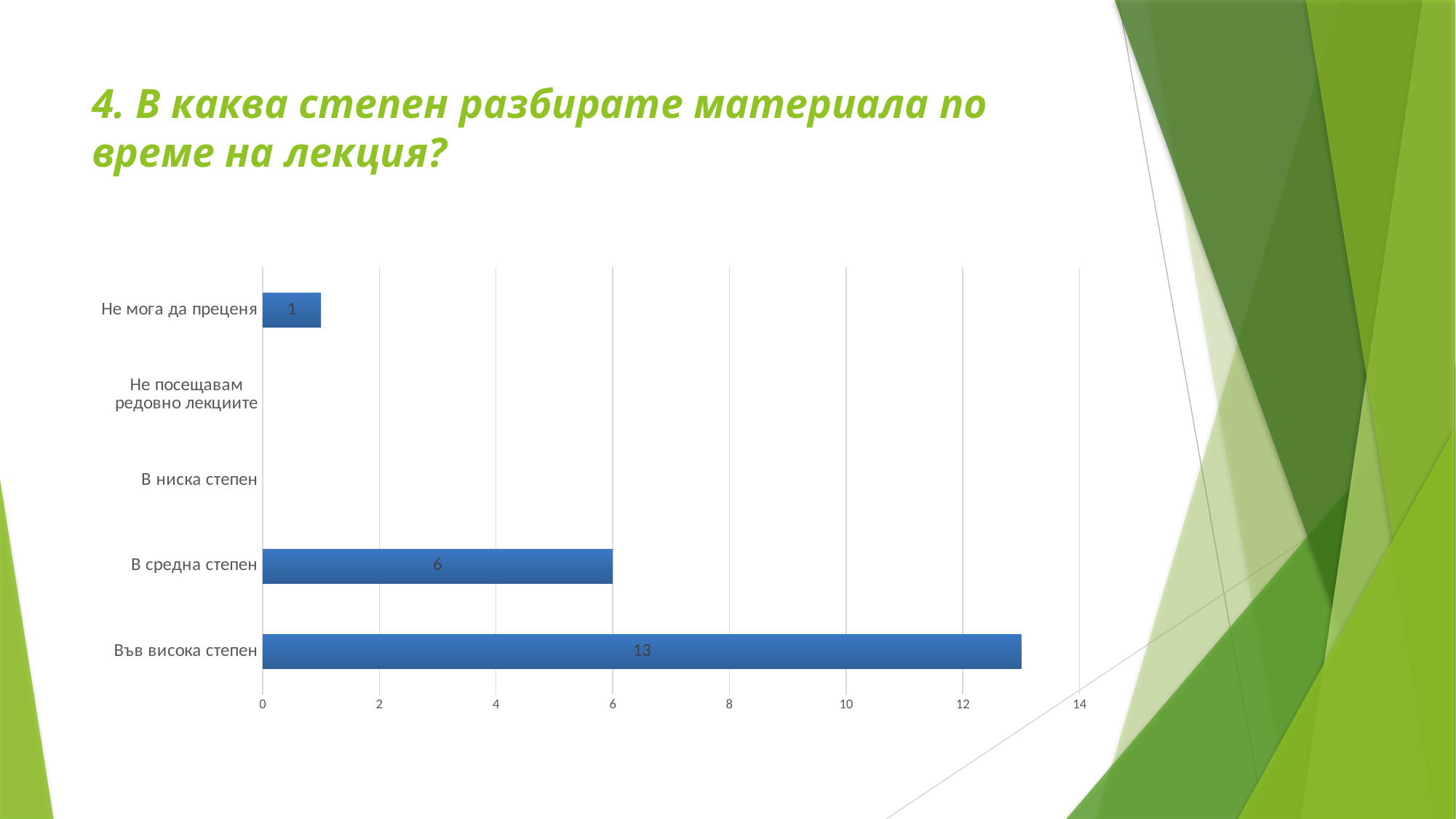
How many categories are listed on the vertical axis of the chart? 5 What is the value for "Във висока степен"? 13 Which category with a visible bar has the lowest value? Не мога да преценя Is the value for "Във висока степен" greater or less than 12? greater Which is larger: the value for "В средна степен" or the value for "Не мога да преценя"? В средна степен Which category has the highest value? Във висока степен What is the maximum value shown on the horizontal axis of the chart? 14 What is the value for "В средна степен"? 6 What is the value for "Не мога да преценя"? 1 What is the difference between the values for "В средна степен" and "Не мога да преценя"? 5 What is the difference between the values for "Във висока степен" and "В средна степен"? 7 What type of chart is shown on the slide? bar chart